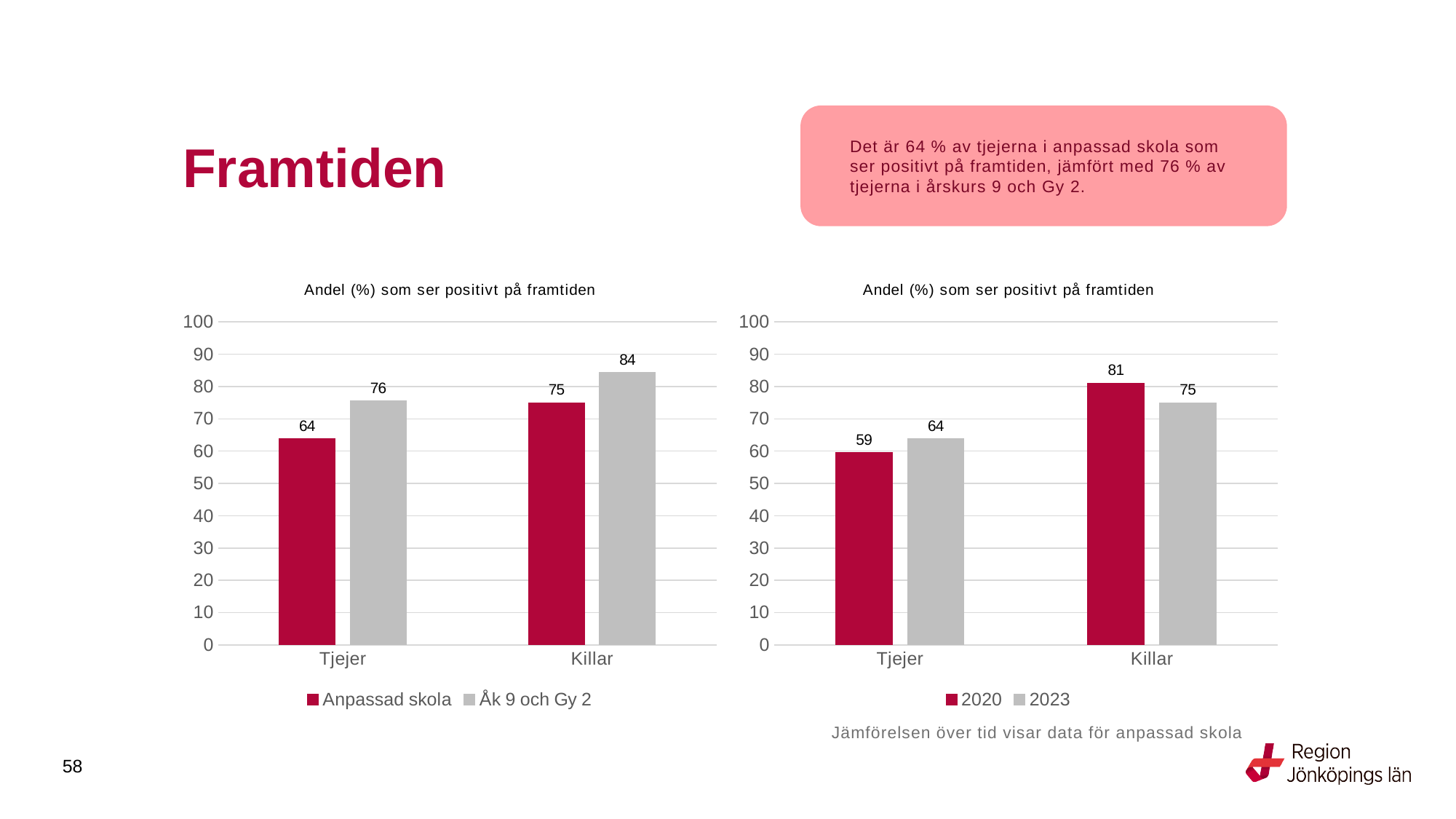
In the left chart, which category has the highest value in the Anpassad skola series? Killar What are the two legend entries of the left chart? Anpassad skola and Åk 9 och Gy 2 What type of chart is the left chart? Bar chart In the right chart, which is larger for Killar: the 2020 value or the 2023 value? 2020 In the left chart, what is the difference between the Åk 9 och Gy 2 value and the Anpassad skola value for Tjejer? 12 In the right chart, what is the value for Killar in 2023? 75 In the right chart, what is the difference between the 2020 and 2023 values for Killar? 6 In the left chart, what is the value for Killar in the Åk 9 och Gy 2 series? 84 In the left chart, what is the value for Tjejer in the Anpassad skola series? 64 How many series does the legend of the right chart list? 2 In the right chart, which category has the lowest value in the 2023 series? Tjejer In the right chart, what is the value for Tjejer in 2020? 59